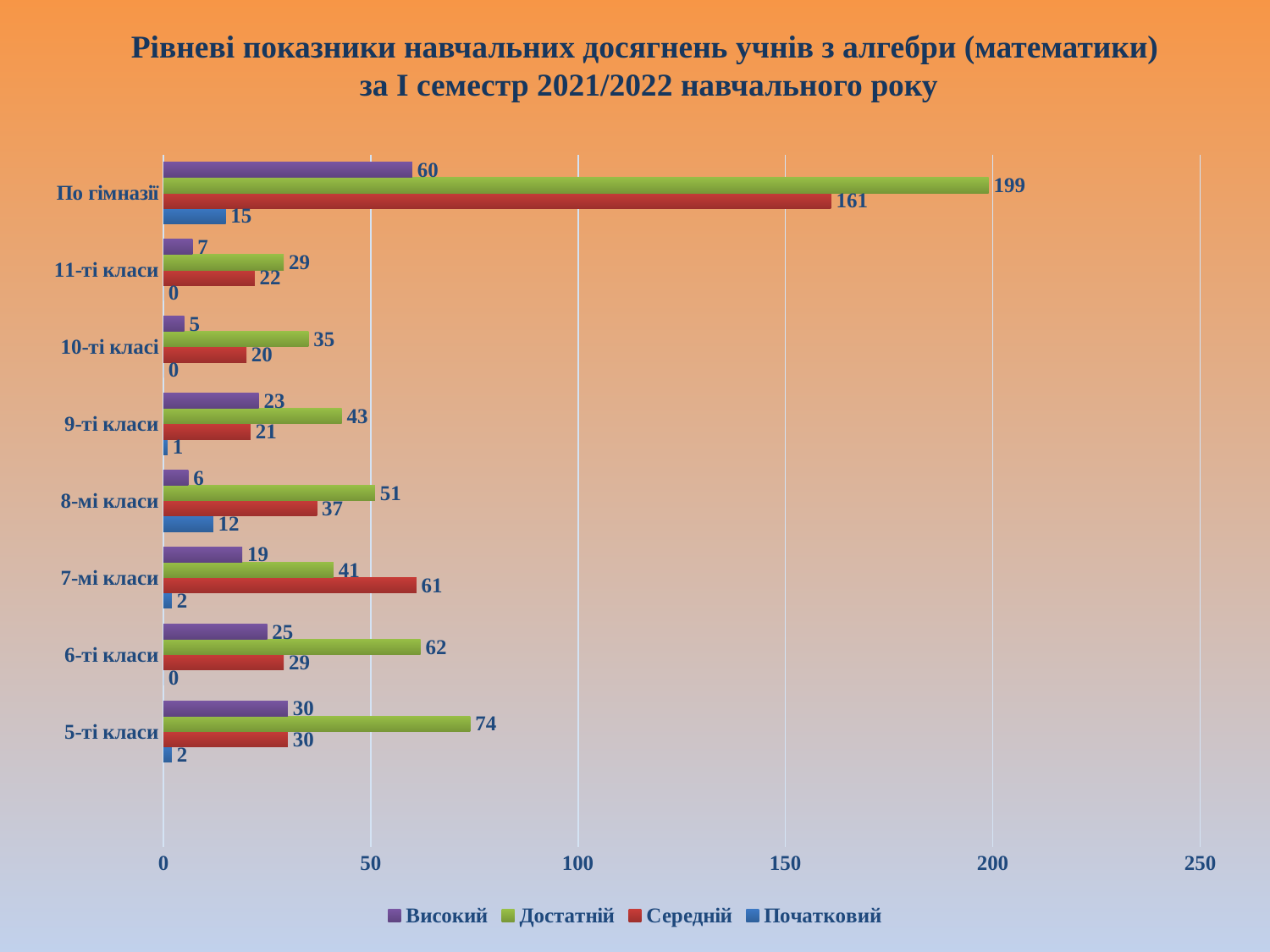
What is the difference between the Достатній and Середній values for 7-мі класи? 20 How many series does the legend list? 4 What colour represents the Початковий series in the legend? blue Among the class categories (excluding По гімназії), which has the lowest value in the Достатній series? 11-ті класи What kind of chart is shown on the slide? bar chart What is the value of the Початковий series for 8-мі класи? 12 What is the value of the Середній series for По гімназії? 161 How many categories are shown on the vertical axis? 8 Which is larger for 6-ті класи: the Високий value or the Середній value? Середній Is the Достатній value for По гімназії greater or less than 150? greater What is the value of the Достатній series for 5-ті класи? 74 Which category has the highest value in the Високий series? По гімназії